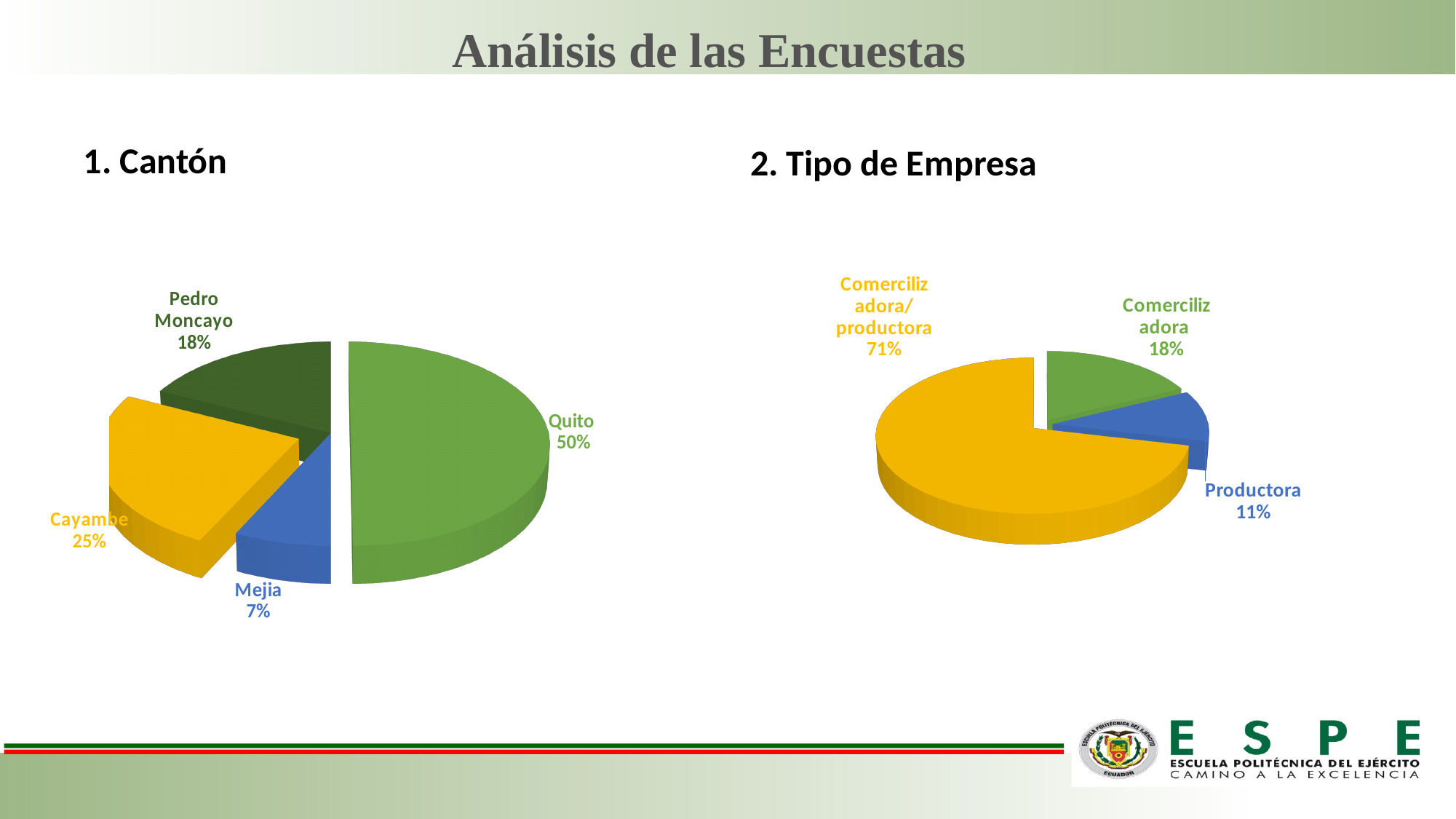
In the '1. Cantón' chart, how many cantones are shown? 4 In the '2. Tipo de Empresa' chart, how many categories are shown? 3 In the '1. Cantón' chart, which cantón has the largest share? Quito What kind of chart is the '1. Cantón' chart? Pie chart In the '1. Cantón' chart, what is the difference between the shares of Cayambe and Pedro Moncayo? 7% In the '1. Cantón' chart, which cantón has the smallest share? Mejia In the '2. Tipo de Empresa' chart, which is larger, Comercializadora or Productora? Comercilizadora In the '2. Tipo de Empresa' chart, which type of company has the largest share? Comercilizadora/productora In the '2. Tipo de Empresa' chart, what share does Productora have? 11% In the '1. Cantón' chart, what share does Cayambe have? 25% In the '2. Tipo de Empresa' chart, what share does Comercializadora/productora have? 71% In the '1. Cantón' chart, what share does Quito have? 50%